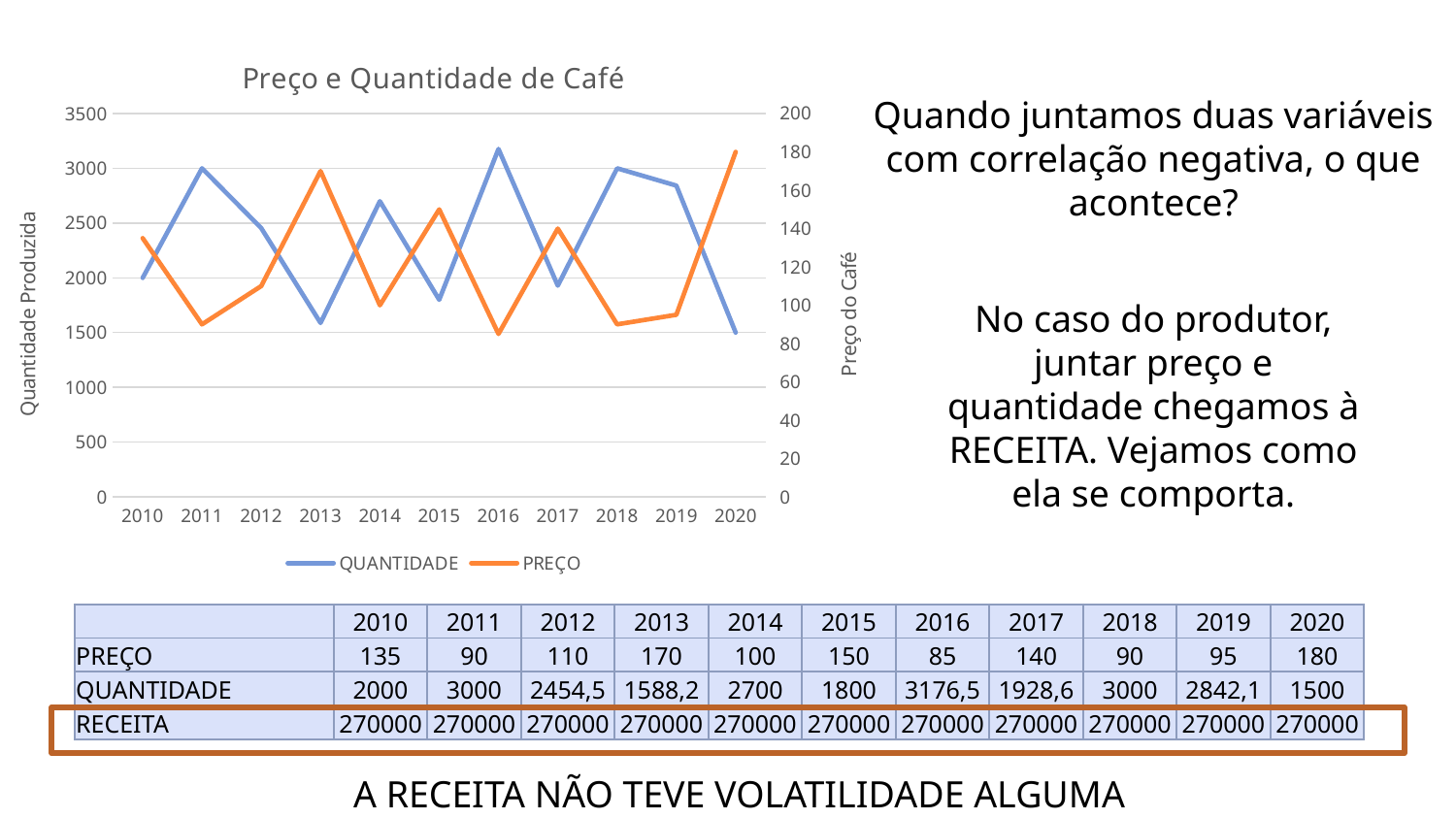
Is the QUANTIDADE value for 2016 greater or less than 3000? greater What is the value of QUANTIDADE in 2014? 2700 Which year has the larger QUANTIDADE, 2011 or 2019? 2011 What is the title of the chart? Preço e Quantidade de Café How many years are plotted along the x axis of the chart? 11 What is the value of PREÇO in 2013? 170 What kind of chart is shown on the slide? line chart What is the label of the right-hand vertical axis of the chart? Preço do Café How many series does the legend of the chart list? 2 In which year is QUANTIDADE highest? 2016 In which year is PREÇO lowest? 2016 By how much is PREÇO in 2020 higher than PREÇO in 2010? 45